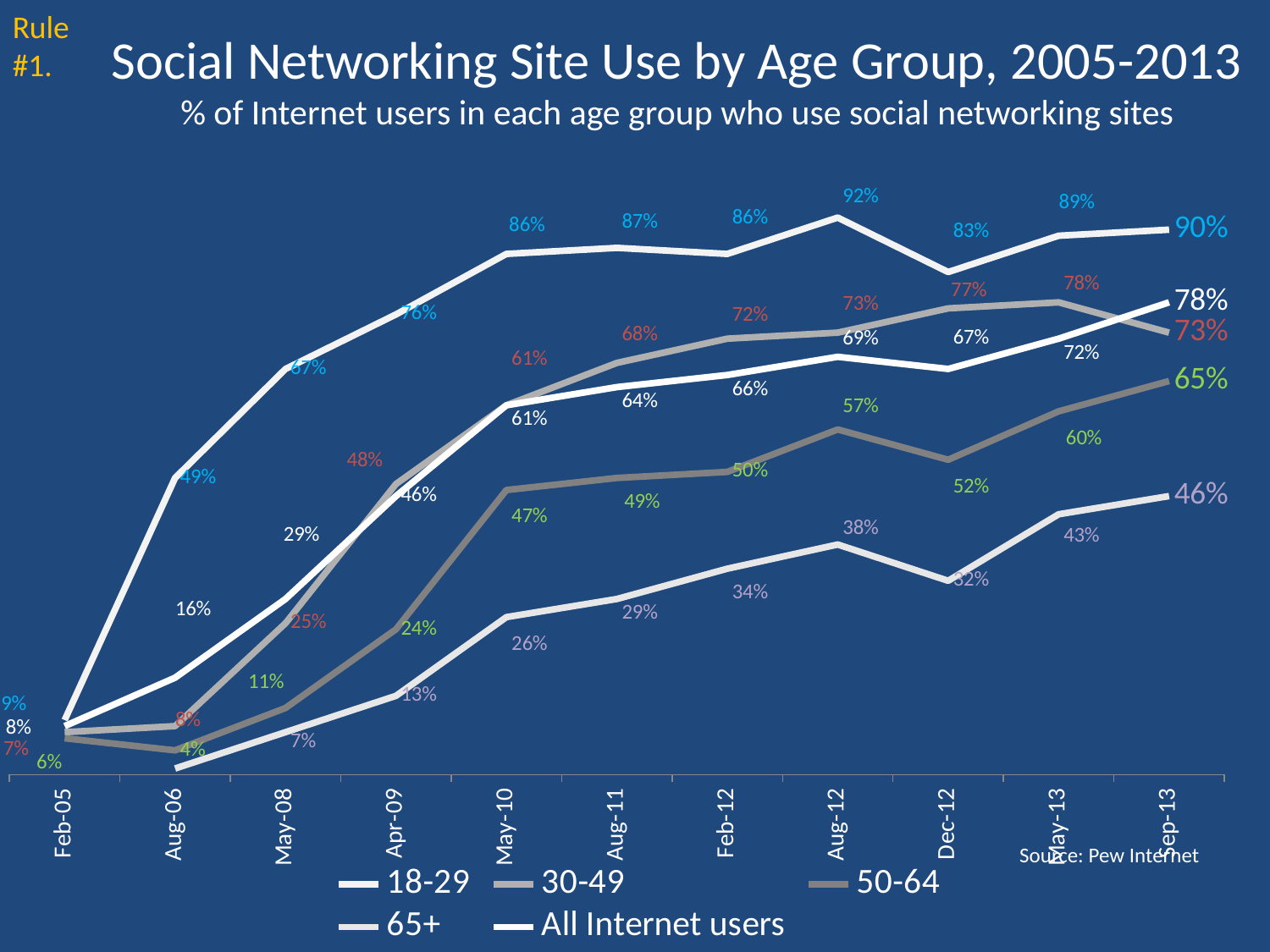
What is the value for the 65+ age group in Sep-13? 46% In Sep-13, which is larger: the value for 30-49 or the value for 50-64? 30-49 How many time points are shown along the x axis? 11 Does the value for All Internet users generally rise or fall from Feb-05 to Sep-13? rise What is the difference between the 18-29 value and the 65+ value in Sep-13? 44% What is the value for All Internet users in Sep-13? 78% How many series does the legend list? 5 Which age group has the lowest value in Sep-13? 65+ What is the value for the 18-29 age group in Sep-13? 90% What is the value for the 50-64 age group in May-10? 47% What type of chart is shown on the slide? line chart At which time point does the 18-29 age group reach its highest value? Aug-12